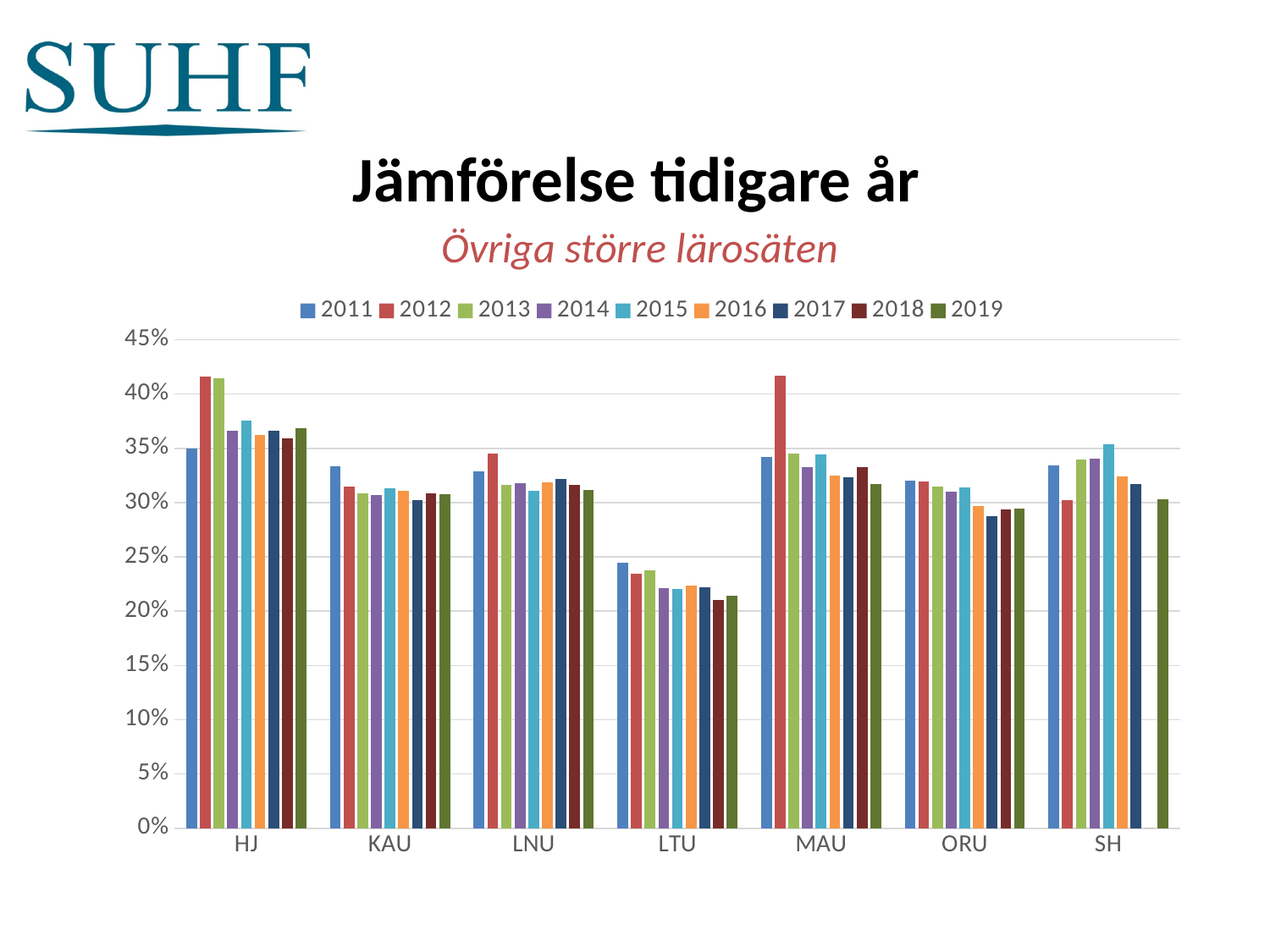
What is the subtitle shown below the chart title? Övriga större lärosäten For LTU, do the values generally rise or fall from 2011 to 2019? fall Which is larger for SH: the 2011 value or the 2012 value? 2011 Is the value for LTU in 2011 greater or less than 25%? less Is the value for ORU in 2017 greater or less than 30%? less Which institution has the lowest values across all years? LTU How many series does the legend list? 9 Which is larger for MAU: the 2011 value or the 2012 value? 2012 Is the value for LTU in 2018 greater or less than 20%? greater How many categories (institutions) are shown on the x axis? 7 What kind of chart is shown on the slide? bar chart